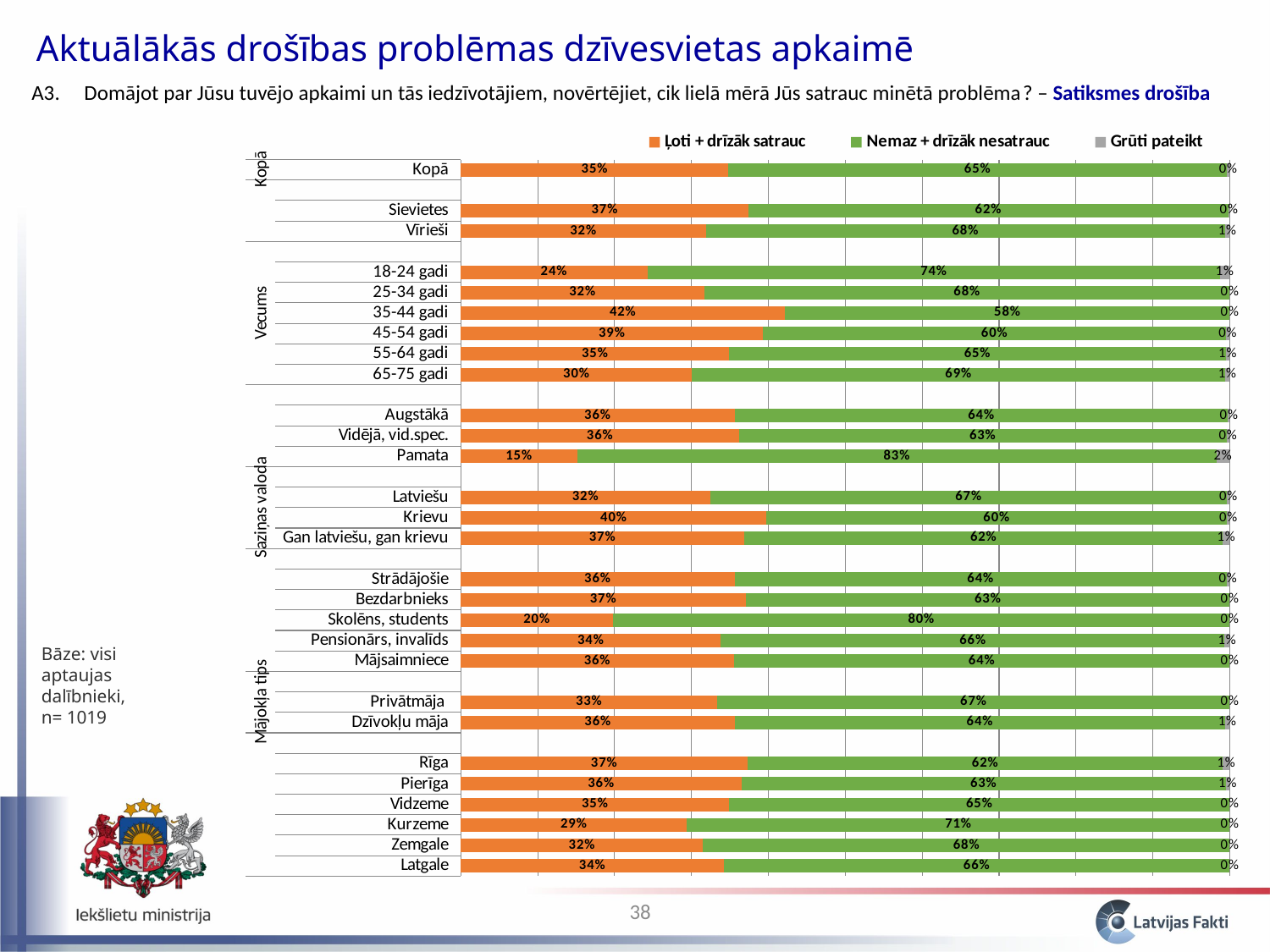
How many age groups are shown in the Vecums section? 6 What is the difference in percentage points between the "Ļoti + drīzāk satrauc" values for Sievietes and Vīrieši? 5 What percentage of the Kopā group answered "Ļoti + drīzāk satrauc"? 35% What colour represents the "Grūti pateikt" series in the legend? Grey Which has a larger "Ļoti + drīzāk satrauc" value, Rīga or Kurzeme? Rīga What kind of chart is shown on the slide? Stacked bar chart Among the age groups (Vecums), which has the highest "Ļoti + drīzāk satrauc" value? 35-44 gadi Which category has the lowest "Ļoti + drīzāk satrauc" value on the chart? Pamata How many series does the legend list? 3 What is the "Ļoti + drīzāk satrauc" value for Skolēns, students? 20% What is the "Nemaz + drīzāk nesatrauc" value for the Pamata category? 83% What is the "Nemaz + drīzāk nesatrauc" value for Kurzeme? 71%